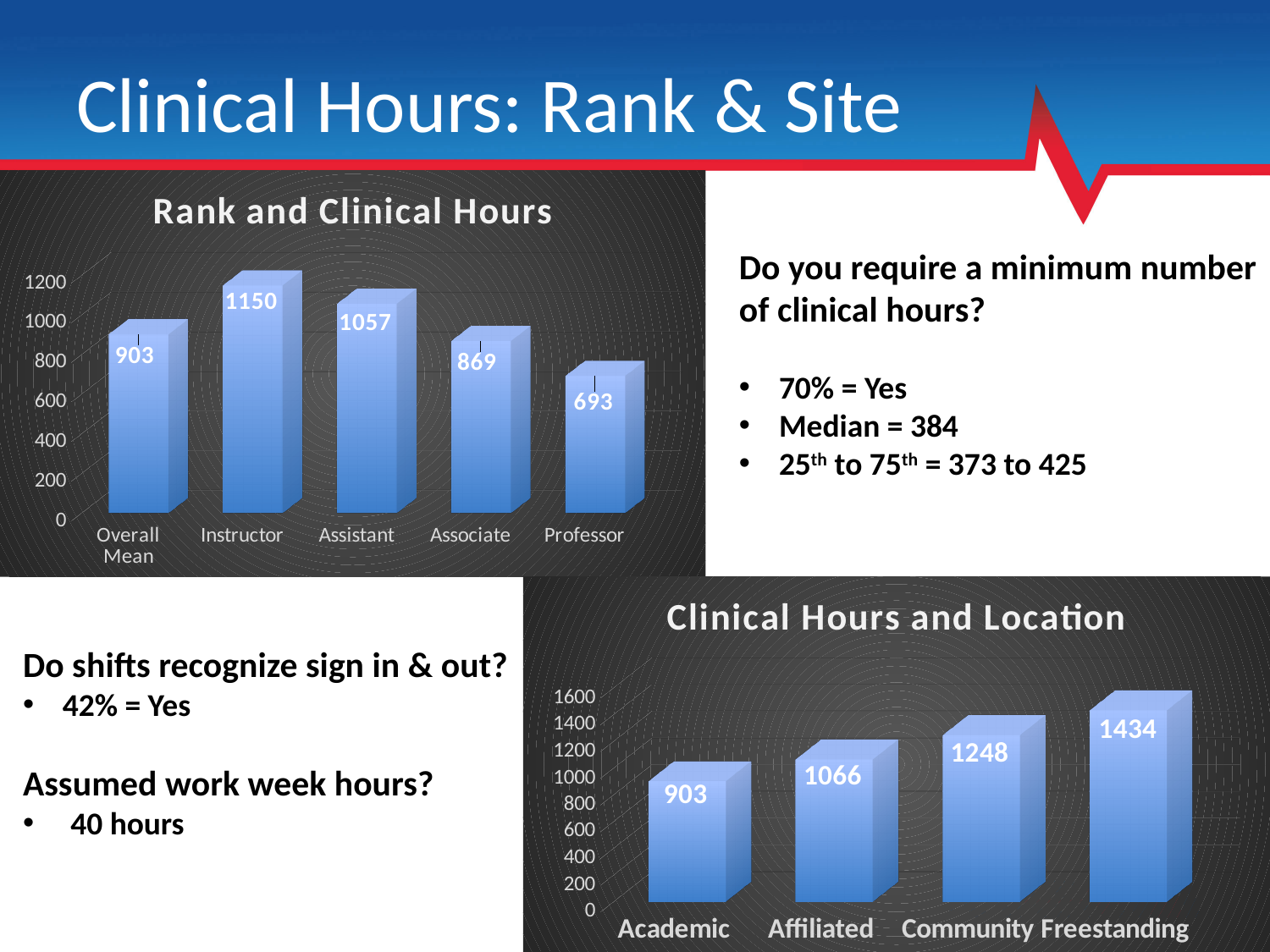
In the 'Rank and Clinical Hours' chart, which category has the lowest value? Professor In the 'Rank and Clinical Hours' chart, does the value for Associate exceed the value for Overall Mean? No In the 'Clinical Hours and Location' chart, what is the value for Community? 1248 What type of chart is the 'Clinical Hours and Location' chart? Bar chart In the 'Clinical Hours and Location' chart, do the values rise or fall from left to right? Rise In the 'Rank and Clinical Hours' chart, how many categories are shown? 5 In the 'Clinical Hours and Location' chart, which category has the highest value? Freestanding In the 'Rank and Clinical Hours' chart, what is the difference between the Instructor and Assistant values? 93 In the 'Clinical Hours and Location' chart, what is the difference between Freestanding and Academic? 531 In the 'Rank and Clinical Hours' chart, what is the value for Professor? 693 In the 'Rank and Clinical Hours' chart, what is the value for Instructor? 1150 In the 'Rank and Clinical Hours' chart, which category has the highest value? Instructor